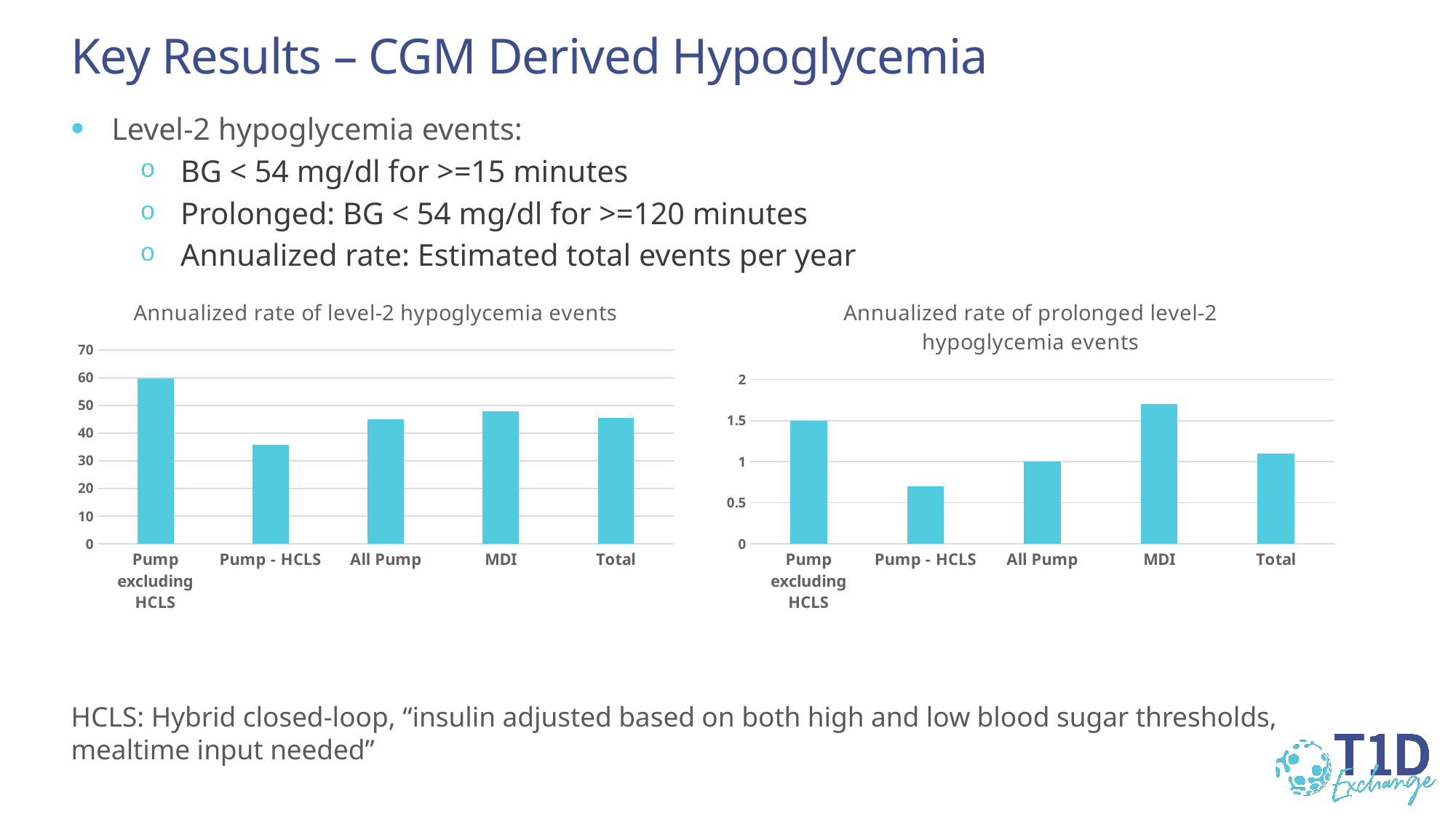
In the chart titled 'Annualized rate of prolonged level-2 hypoglycemia events', which category has the lowest value? Pump - HCLS In the chart titled 'Annualized rate of prolonged level-2 hypoglycemia events', is the value for Pump - HCLS greater or less than 1? less In the chart titled 'Annualized rate of level-2 hypoglycemia events', is the value for MDI greater or less than 50? less In the chart titled 'Annualized rate of level-2 hypoglycemia events', which is larger, Pump excluding HCLS or Total? Pump excluding HCLS In the chart titled 'Annualized rate of prolonged level-2 hypoglycemia events', which is larger, MDI or Total? MDI In the chart titled 'Annualized rate of prolonged level-2 hypoglycemia events', is the value for MDI greater or less than 1.5? greater What kind of chart is the chart on the right of the slide? Bar chart How many categories are shown in the chart titled 'Annualized rate of level-2 hypoglycemia events'? 5 In the chart titled 'Annualized rate of level-2 hypoglycemia events', which category has the highest value? Pump excluding HCLS In the chart titled 'Annualized rate of prolonged level-2 hypoglycemia events', which category has the highest value? MDI In the chart titled 'Annualized rate of level-2 hypoglycemia events', which category has the lowest value? Pump - HCLS